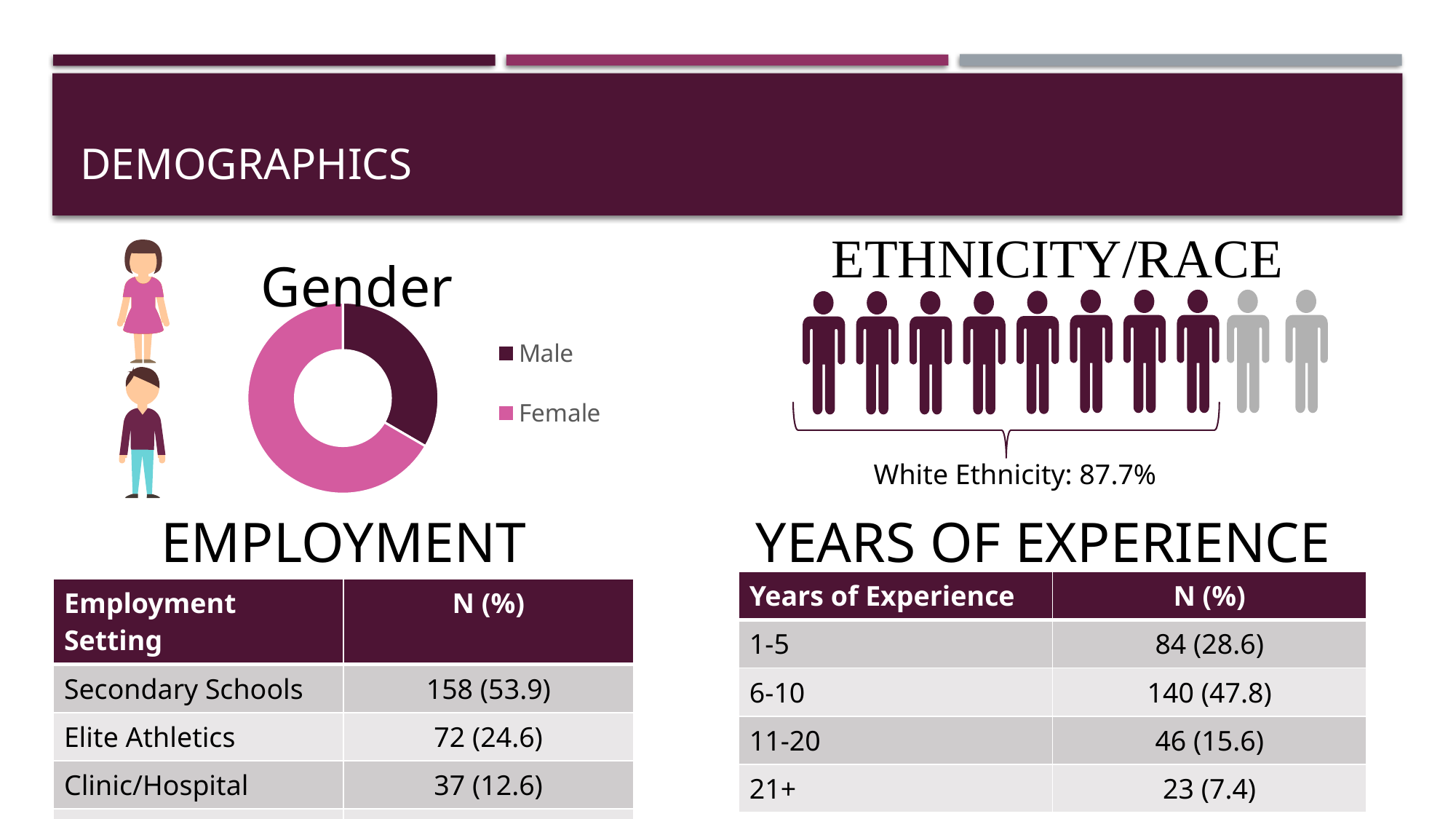
What kind of chart is the Gender chart? Donut chart Which category has the smallest share in the Gender chart? Male In the Gender chart, which is larger, the Male slice or the Female slice? Female How many categories does the Gender chart show? 2 Which category has the largest share in the Gender chart? Female Is the Female share in the Gender chart greater or less than 50%? greater How many entries does the legend of the Gender chart list? 2 What colour represents Female in the Gender chart? Pink What is the title of the chart on the left of the slide? Gender Is the Male share in the Gender chart greater or less than 50%? less